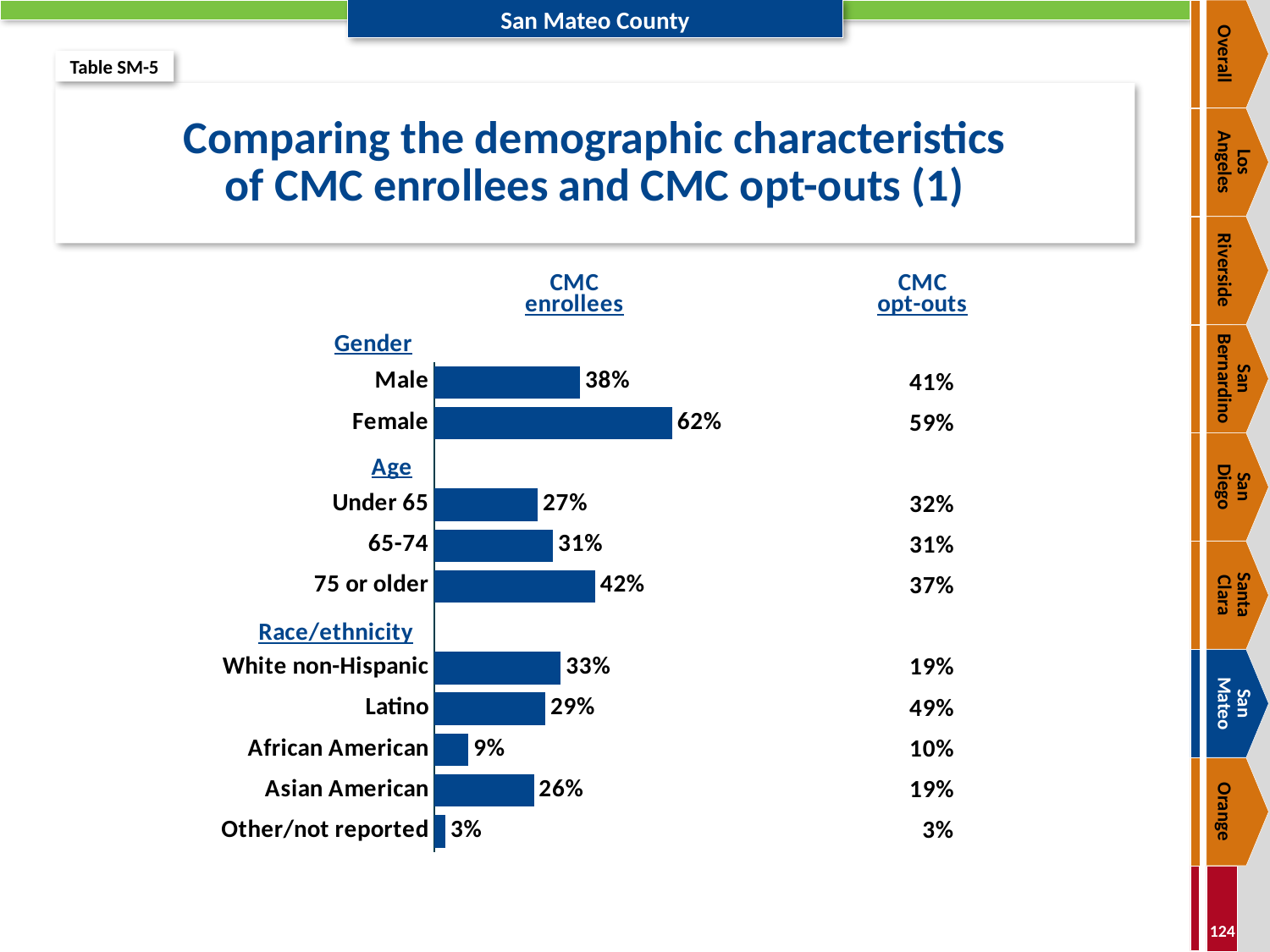
Among the race/ethnicity categories, which has the highest share of CMC enrollees? White non-Hispanic What percentage of CMC enrollees are Female? 62% What percentage of CMC opt-outs are Latino? 49% Which is larger for CMC enrollees: the Under 65 share or the 75 or older share? 75 or older What type of chart is used to show the CMC enrollee percentages? Bar chart Among the race/ethnicity categories, which has the lowest share of CMC enrollees? Other/not reported What is the table number shown in the top-left corner of the slide? Table SM-5 What percentage of CMC enrollees are 75 or older? 42% What percentage of CMC enrollees are Asian American? 26% How many demographic categories have bars in the chart? 10 What is the difference between the Latino percentage for CMC opt-outs and for CMC enrollees? 20% What is the difference between the Female and Male percentages for CMC enrollees? 24%